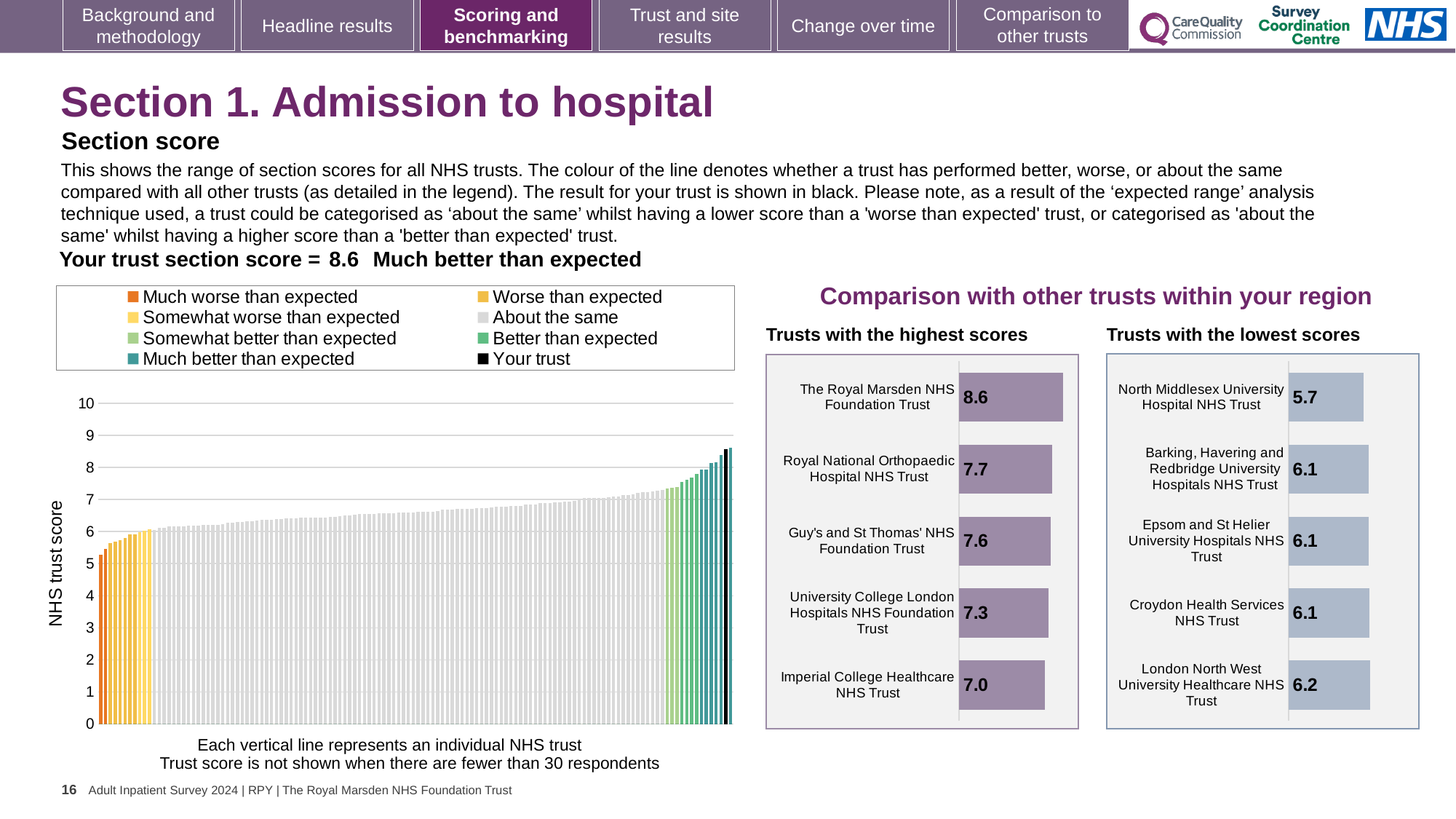
In the 'Trusts with the highest scores' chart, which trust has the highest score? The Royal Marsden NHS Foundation Trust How many entries does the legend of the NHS trust score chart on the left list? 8 What kind of chart is the NHS trust score chart on the left of the slide? bar chart In the 'Trusts with the highest scores' chart, which has the higher score: Royal National Orthopaedic Hospital NHS Trust or University College London Hospitals NHS Foundation Trust? Royal National Orthopaedic Hospital NHS Trust How many trusts are shown in the 'Trusts with the highest scores' chart? 5 In the 'Trusts with the lowest scores' chart, which trust has the lowest score? North Middlesex University Hospital NHS Trust In the 'Trusts with the lowest scores' chart, what is the difference between the scores of London North West University Healthcare NHS Trust and North Middlesex University Hospital NHS Trust? 0.5 In the 'Trusts with the highest scores' chart, what is the score for The Royal Marsden NHS Foundation Trust? 8.6 In the 'Trusts with the highest scores' chart, what is the difference between the scores of The Royal Marsden NHS Foundation Trust and Imperial College Healthcare NHS Trust? 1.6 In the NHS trust score chart on the left, do the values rise or fall from left to right? rise In the 'Trusts with the highest scores' chart, what is the score for Guy's and St Thomas' NHS Foundation Trust? 7.6 In the 'Trusts with the lowest scores' chart, what is the score for London North West University Healthcare NHS Trust? 6.2